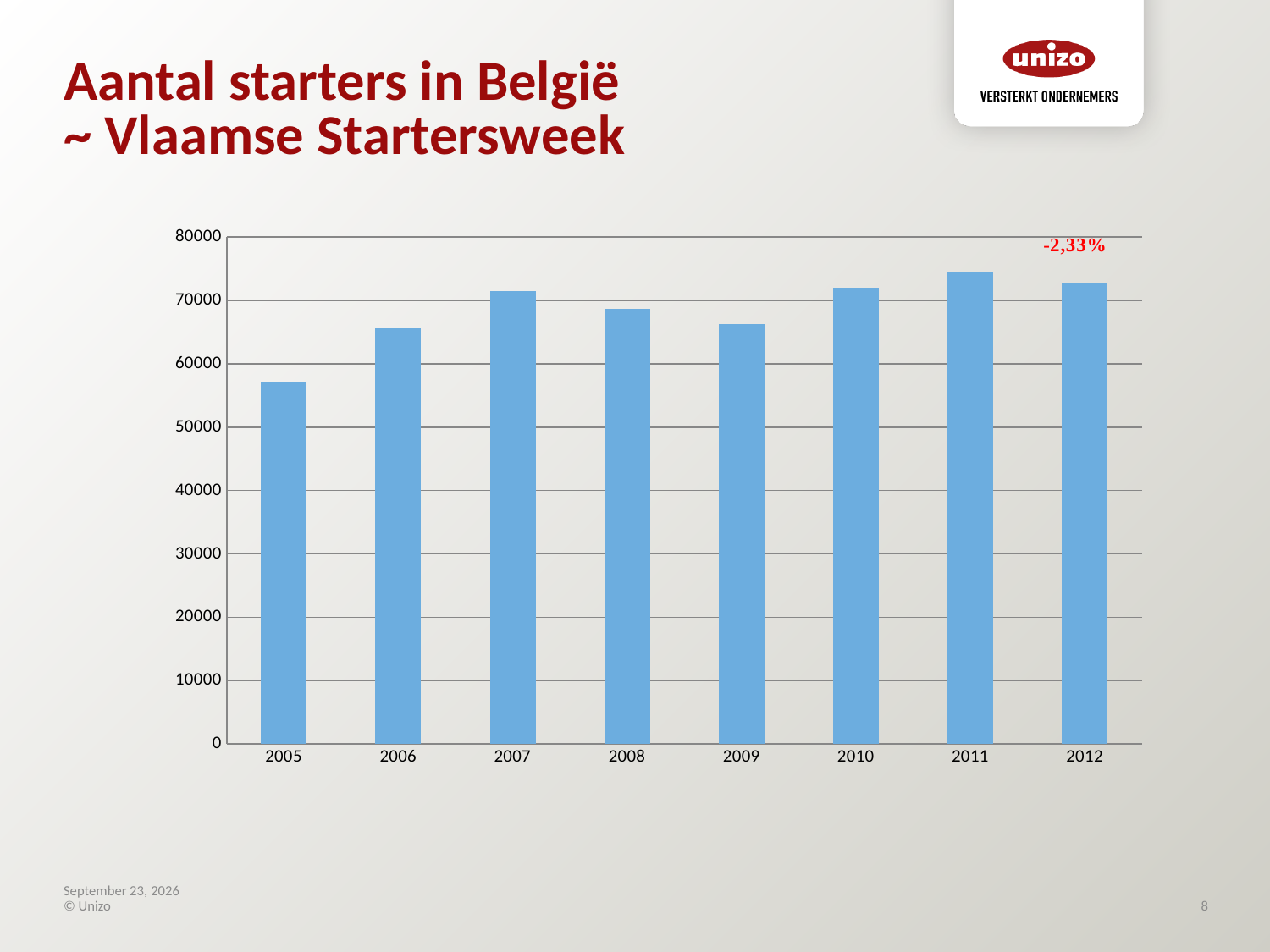
Which year has a larger value, 2005 or 2006? 2006 Do the values rise or fall from 2005 to 2007? Rise What percentage annotation is printed in red above the 2012 bar? -2,33% Which year has the lowest number of starters in the chart? 2005 How many years are shown on the x axis of the chart? 8 What kind of chart is shown on the slide? Bar chart Which year has a larger value, 2007 or 2008? 2007 Is the value for 2009 greater or less than 70000? less Is the value for 2011 greater or less than 70000? greater Is the value for 2005 greater or less than 60000? less Which year has the highest number of starters in the chart? 2011